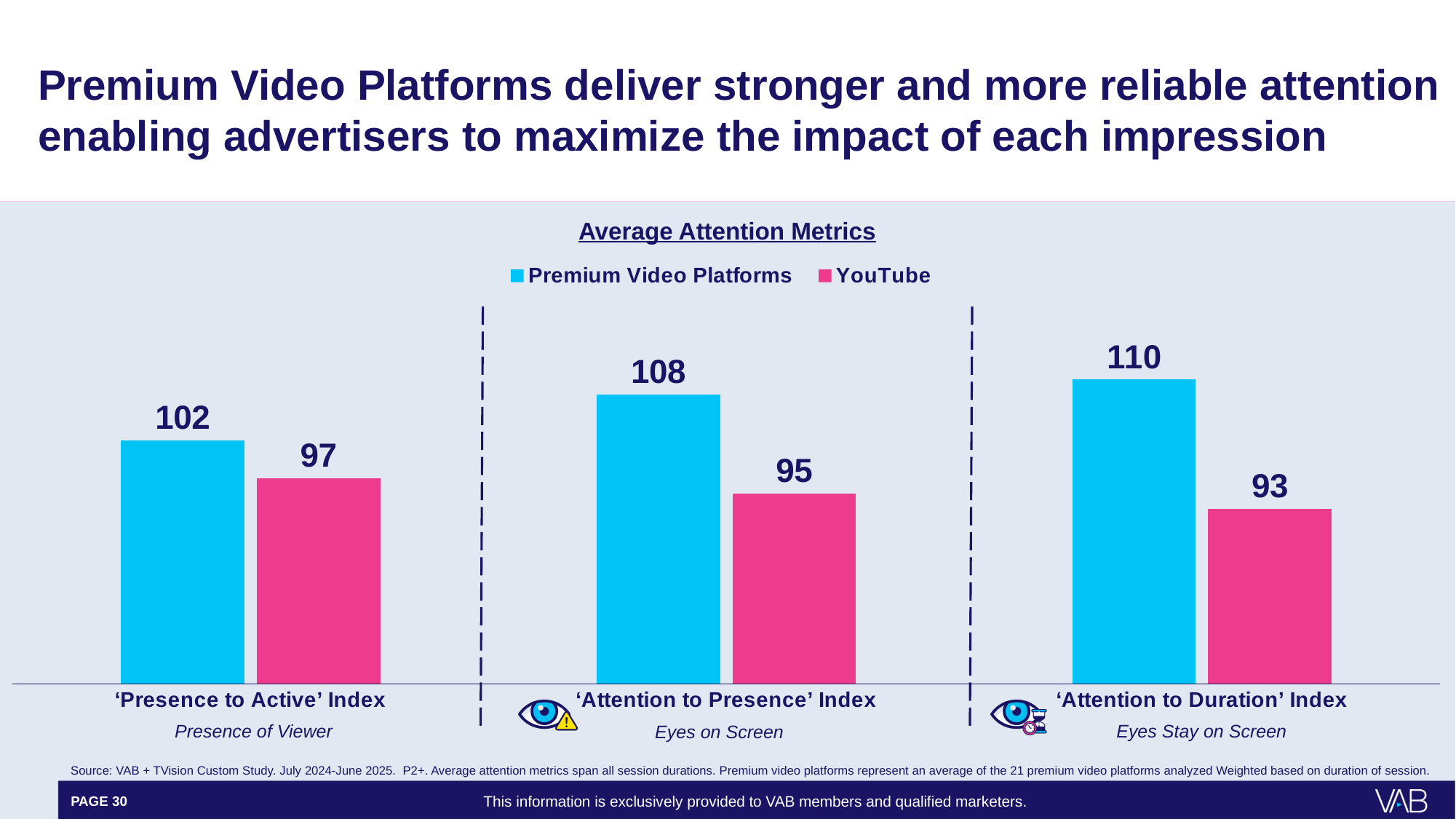
Which is larger on the 'Presence to Active' Index: Premium Video Platforms or YouTube? Premium Video Platforms What is the difference between Premium Video Platforms and YouTube on the 'Attention to Presence' Index? 13 What is the difference between Premium Video Platforms and YouTube on the 'Attention to Duration' Index? 17 How many series does the legend list? 2 What is the 'Presence to Active' Index value for YouTube? 97 Which index has the highest value for Premium Video Platforms? 'Attention to Duration' Index What is the 'Attention to Duration' Index value for Premium Video Platforms? 110 Which index has the lowest value for YouTube? 'Attention to Duration' Index What type of chart is shown on the slide? Bar chart How many index categories are shown in the chart? 3 What is the 'Presence to Active' Index value for Premium Video Platforms? 102 What is the 'Attention to Presence' Index value for YouTube? 95